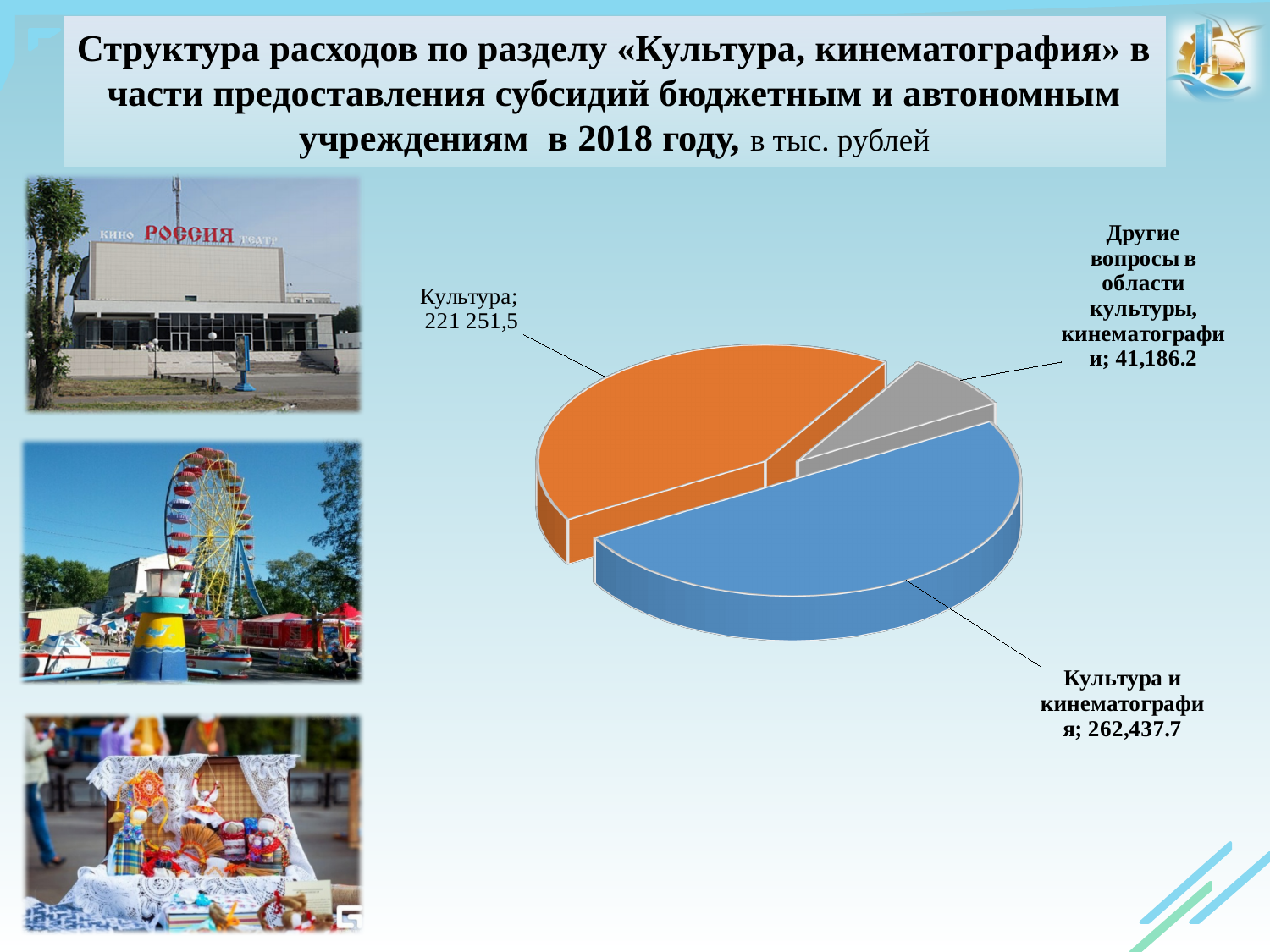
What is the value for «Культура» in the pie chart? 221 251,5 What colour is the slice for «Культура» in the pie chart? orange How many slices does the pie chart have? 3 Which is larger: «Культура» or «Культура и кинематография»? Культура и кинематография In what units are the values in the chart given, according to the slide title? тыс. рублей What is the value for «Другие вопросы в области культуры, кинематографии» in the pie chart? 41,186.2 By how much does «Культура и кинематография» exceed «Культура»? 41,186.2 Which is larger: «Культура» or «Другие вопросы в области культуры, кинематографии»? Культура Which category has the largest slice in the pie chart? Культура и кинематография What is the value for «Культура и кинематография» in the pie chart? 262,437.7 Which category has the smallest slice in the pie chart? Другие вопросы в области культуры, кинематографии What kind of chart is shown on the slide? pie chart